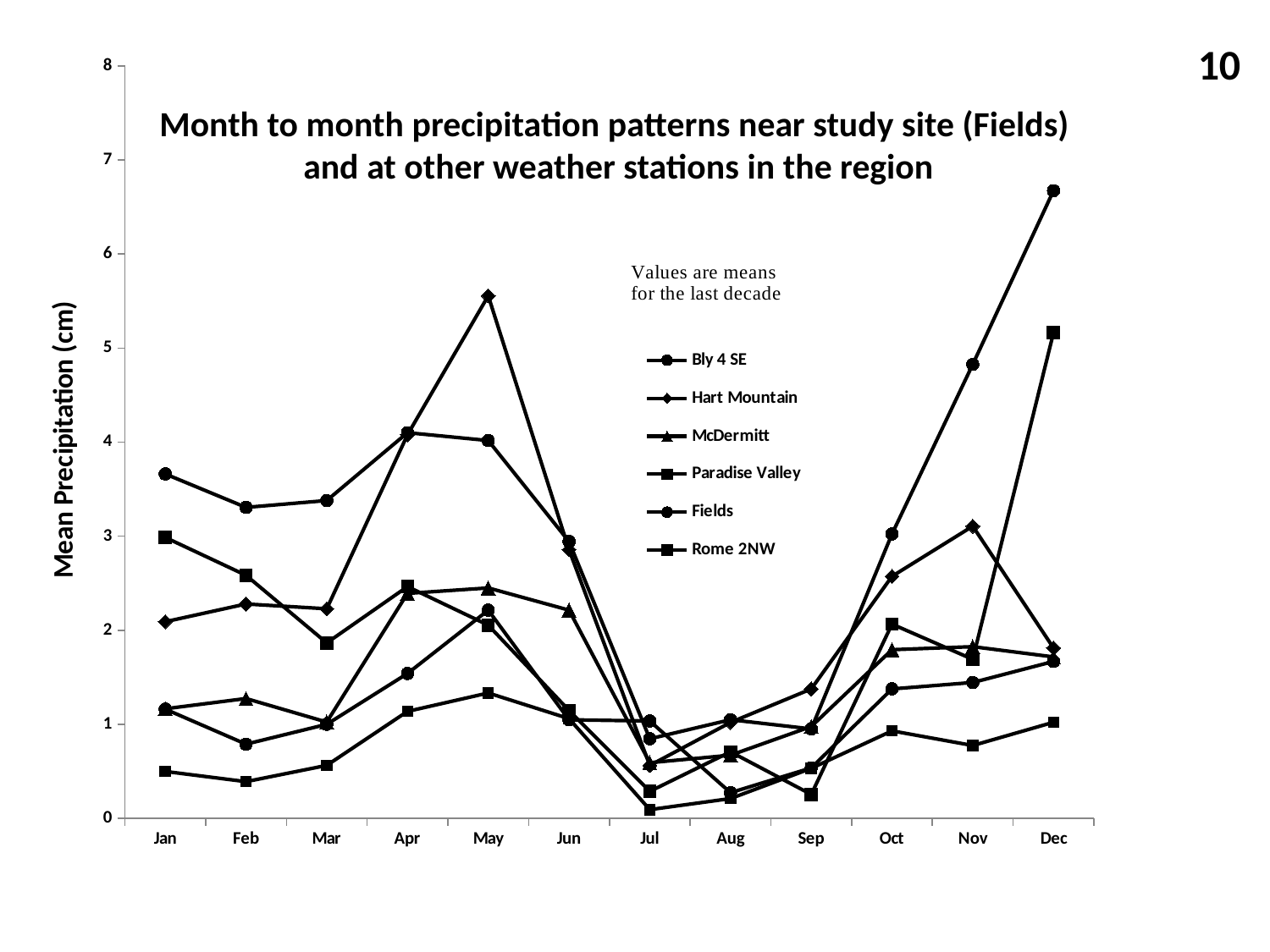
In which month does Hart Mountain have its lowest mean precipitation? Jul In which month does McDermitt have its lowest mean precipitation? Jul Is the value for McDermitt in Jul greater or less than 1? less Is the value for McDermitt in Apr greater or less than 2? greater How many series does the legend list? 6 In which month does Hart Mountain reach its highest mean precipitation? May What is the label of the y axis? Mean Precipitation (cm) Is the value for Hart Mountain in May greater or less than 5? greater What kind of chart is shown on the slide? line chart In May, which has the higher mean precipitation, Hart Mountain or McDermitt? Hart Mountain How many months are plotted along the x axis? 12 In which month does the highest plotted value on the chart occur? Dec